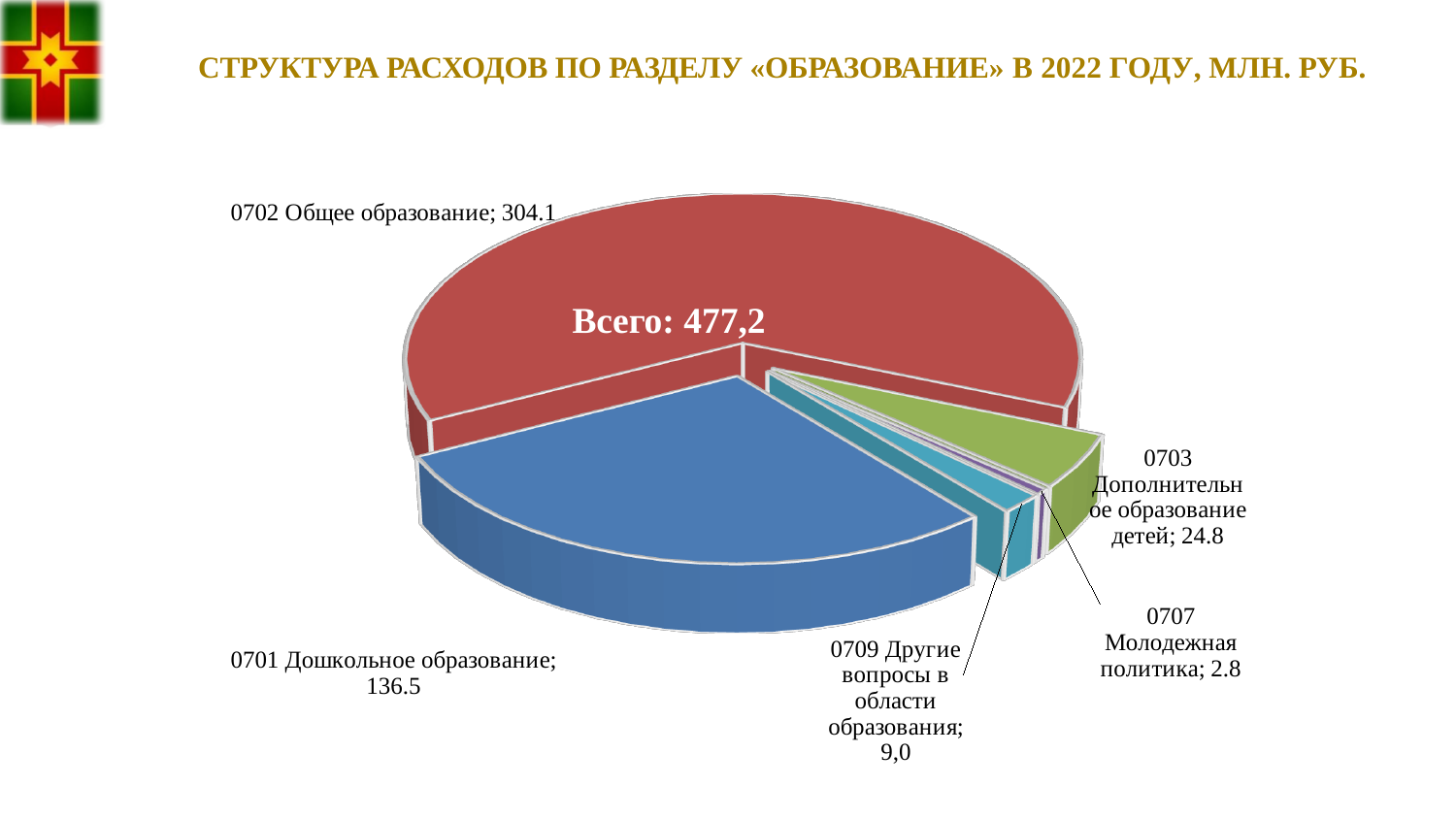
How many slices does the pie chart have? 5 What is the value for 0701 Дошкольное образование? 136.5 What kind of chart is shown on the slide? Pie chart What is the value for 0702 Общее образование? 304.1 Which category has the largest slice of the pie? 0702 Общее образование Which is larger: 0703 Дополнительное образование детей or 0709 Другие вопросы в области образования? 0703 Дополнительное образование детей What is the value for 0709 Другие вопросы в области образования? 9,0 What is the value for 0707 Молодежная политика? 2.8 What is the difference between the values for 0702 Общее образование and 0701 Дошкольное образование? 167.6 What is the value for 0703 Дополнительное образование детей? 24.8 What total value is printed on the chart? Всего: 477,2 Which category has the smallest slice of the pie? 0707 Молодежная политика